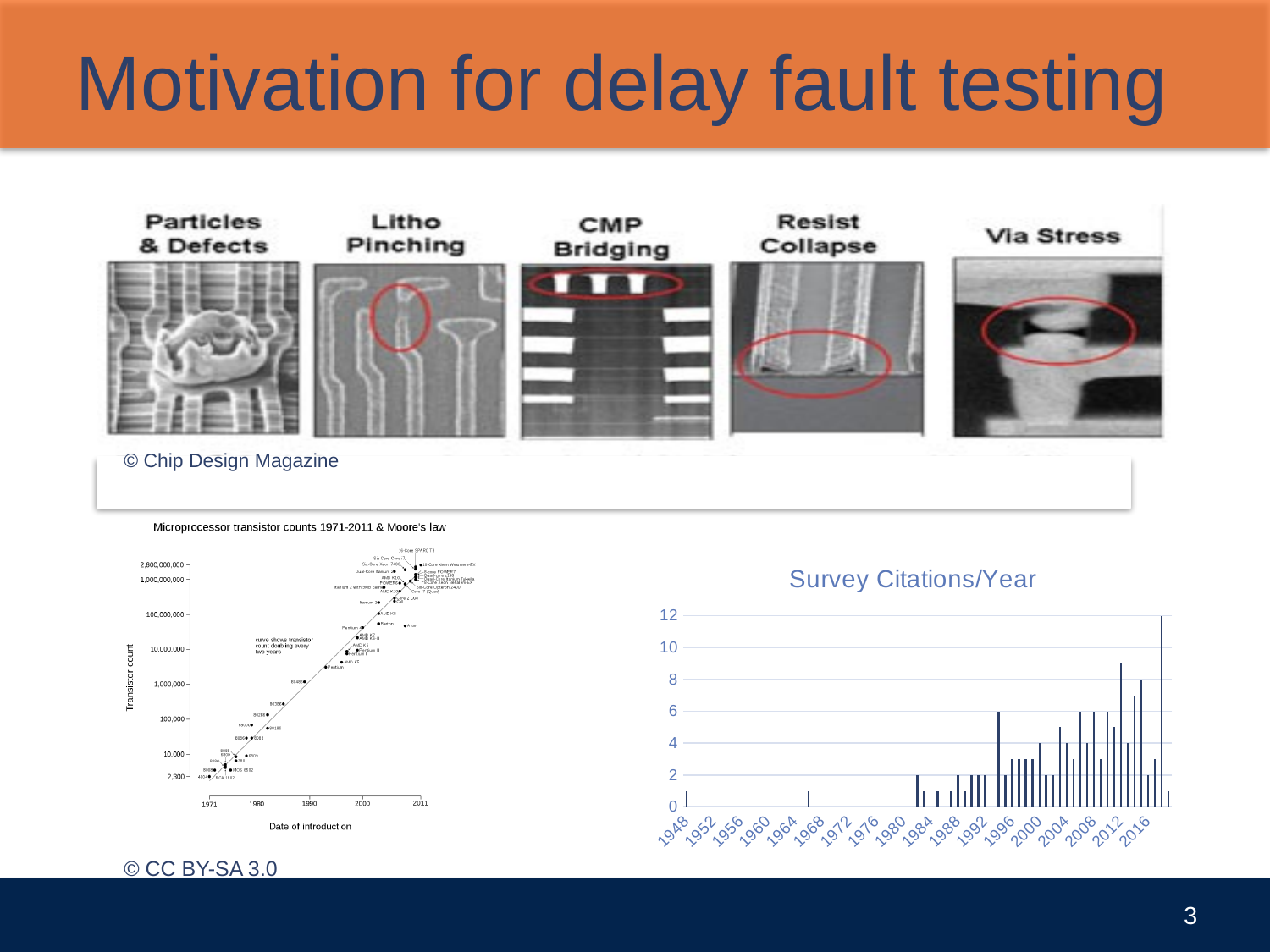
In the 'Microprocessor transistor counts 1971-2011 & Moore's law' chart, do transistor counts rise or fall as the date of introduction increases? rise What type of chart is the 'Survey Citations/Year' chart? bar chart In the 'Microprocessor transistor counts 1971-2011 & Moore's law' chart, what is the label of the x axis? Date of introduction In the 'Survey Citations/Year' chart, what is the highest value shown on the y axis? 12 In the 'Microprocessor transistor counts 1971-2011 & Moore's law' chart, what is the lowest transistor count value marked on the y axis? 2,300 In the 'Survey Citations/Year' chart, is the value for 1948 greater or less than 2? less In the 'Survey Citations/Year' chart, is the tallest bar greater or less than 10? greater In the 'Survey Citations/Year' chart, do the citation counts generally rise or fall from 1948 to 2016? rise